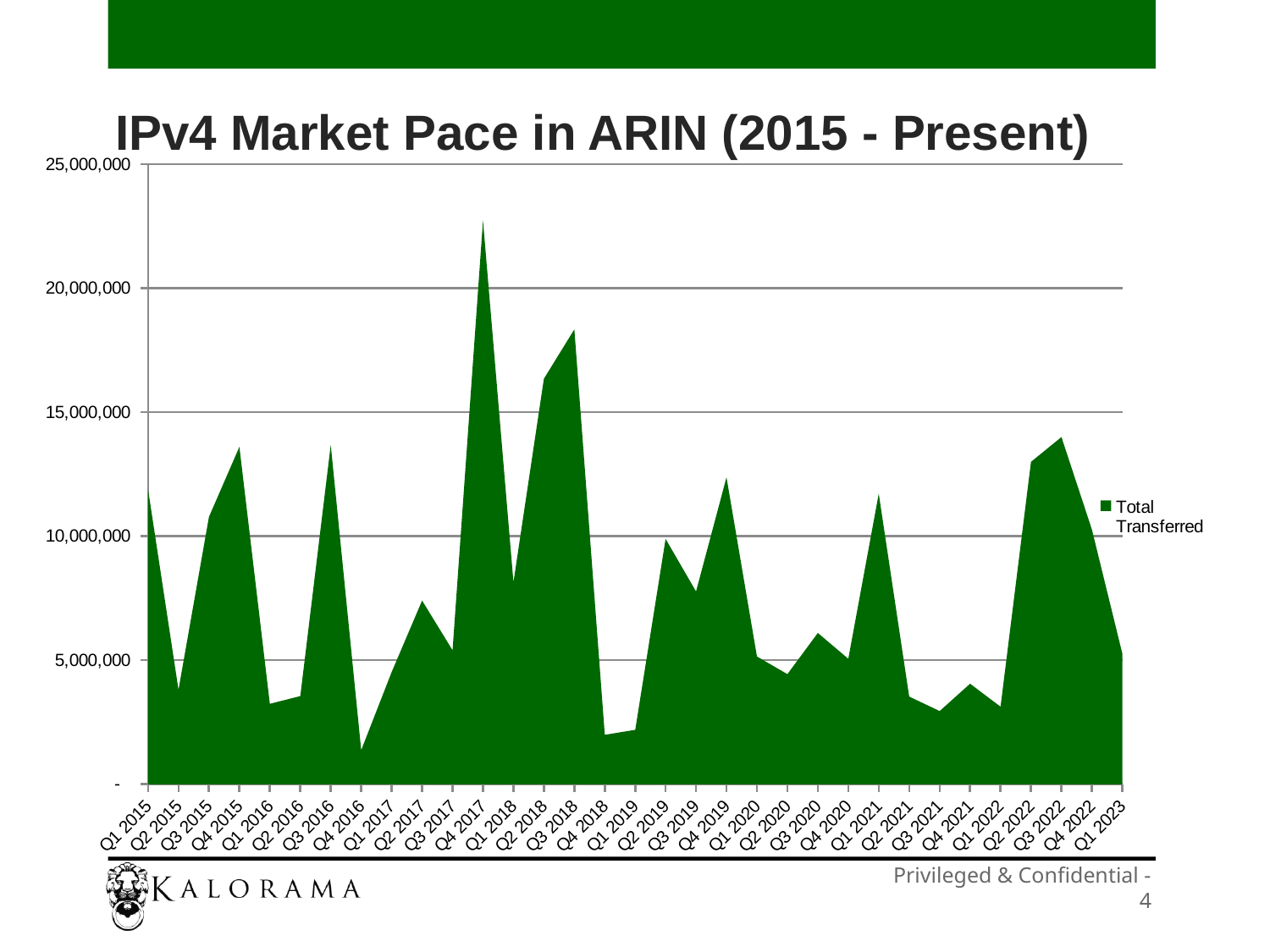
How many series does the legend list? 1 Is the value for Q3 2018 greater or less than 15,000,000? greater What is the name of the series shown in the legend? Total Transferred Which is larger, the value for Q4 2017 or the value for Q3 2018? Q4 2017 How many quarters are plotted along the x axis? 33 Is the value for Q4 2016 greater or less than 5,000,000? less What kind of chart is shown on the slide? Area chart What is the title of the chart? IPv4 Market Pace in ARIN (2015 - Present) Which quarter has the highest Total Transferred value? Q4 2017 Is the value for Q4 2017 greater or less than 20,000,000? greater Which is larger, the value for Q1 2021 or the value for Q1 2022? Q1 2021